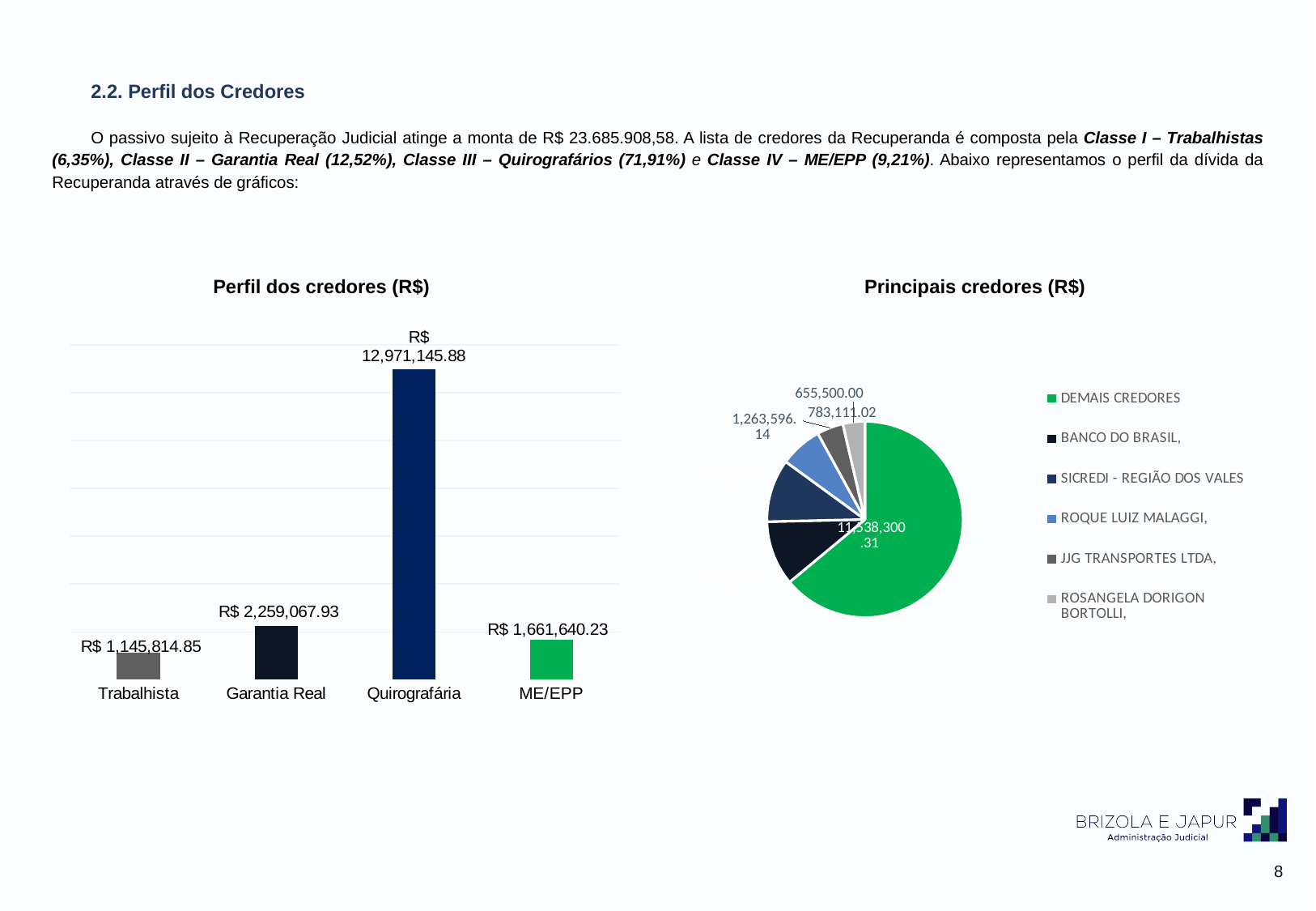
In the 'Perfil dos credores (R$)' chart, which category has the highest value? Quirografária In the 'Perfil dos credores (R$)' chart, what is the value for Trabalhista? R$ 1,145,814.85 In the 'Perfil dos credores (R$)' chart, which is larger, Garantia Real or ME/EPP? Garantia Real What kind of chart is 'Perfil dos credores (R$)'? Bar chart How many categories are shown in the 'Perfil dos credores (R$)' chart? 4 How many entries does the legend of the 'Principais credores (R$)' chart list? 6 In the 'Perfil dos credores (R$)' chart, what is the value for Quirografária? R$ 12,971,145.88 In the 'Perfil dos credores (R$)' chart, what is the value for ME/EPP? R$ 1,661,640.23 In the 'Principais credores (R$)' pie chart, which creditor has the largest slice? DEMAIS CREDORES In the 'Perfil dos credores (R$)' chart, what is the difference between Quirografária and Garantia Real? R$ 10,712,077.95 In the 'Perfil dos credores (R$)' chart, what is the difference between Garantia Real and Trabalhista? R$ 1,113,253.08 In the 'Perfil dos credores (R$)' chart, which category has the lowest value? Trabalhista